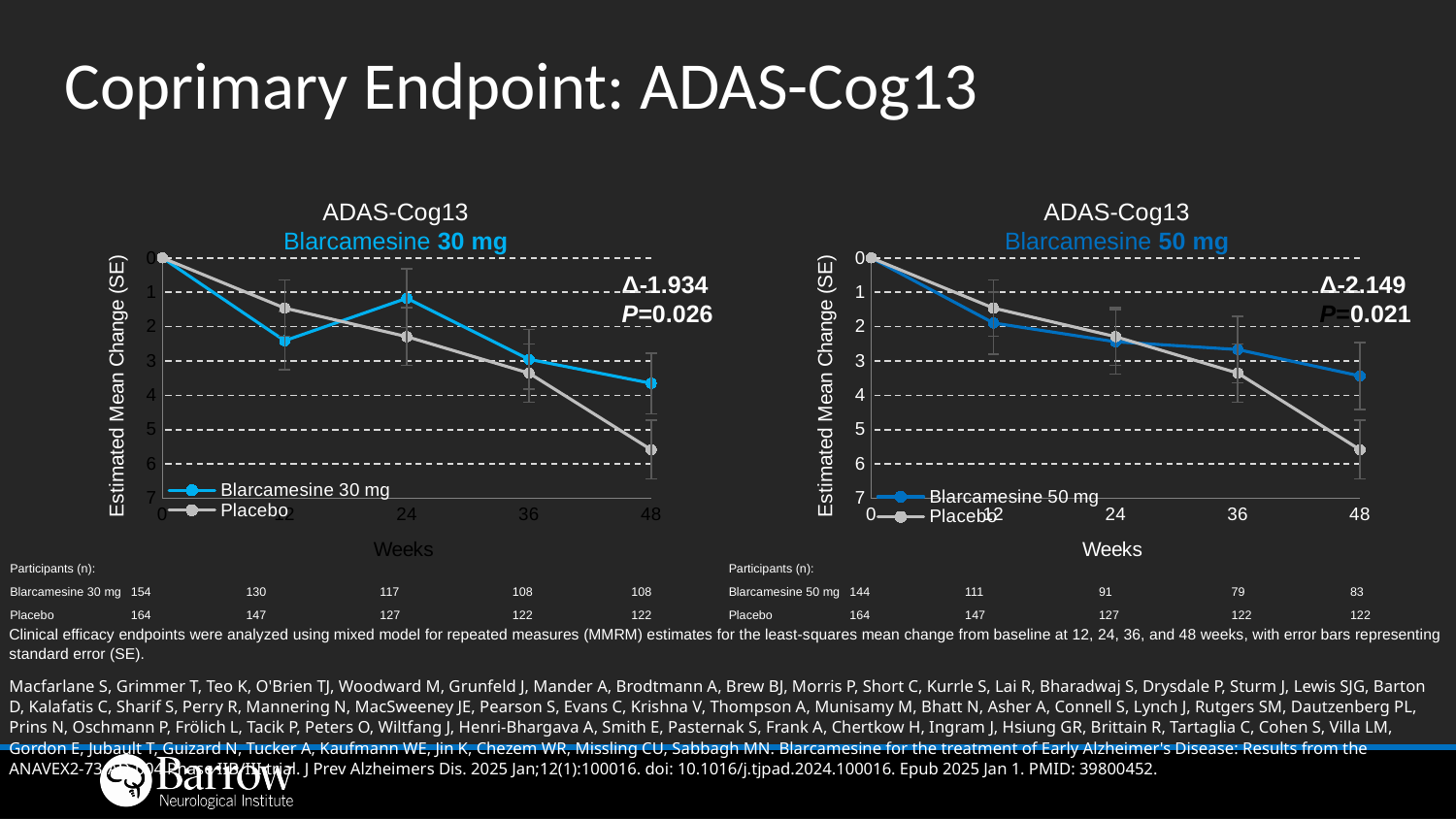
In the ADAS-Cog13 Blarcamesine 50 mg chart on the right, which series has the larger estimated mean change at week 48, Blarcamesine 50 mg or Placebo? Placebo In the ADAS-Cog13 Blarcamesine 30 mg chart on the left, how many time points (weeks) are plotted along the x axis? 5 In the ADAS-Cog13 Blarcamesine 30 mg chart on the left, which series has the larger estimated mean change at week 48, Blarcamesine 30 mg or Placebo? Placebo In the ADAS-Cog13 Blarcamesine 50 mg chart on the right, what P value is annotated on the chart? P=0.021 In the ADAS-Cog13 Blarcamesine 30 mg chart on the left, what Δ value is annotated on the chart? Δ-1.934 What kind of chart is the ADAS-Cog13 Blarcamesine 30 mg chart on the left? line chart In the ADAS-Cog13 Blarcamesine 30 mg chart on the left, is the Placebo value at week 48 greater or less than 5? greater In the ADAS-Cog13 Blarcamesine 50 mg chart on the right, is the Blarcamesine 50 mg value at week 48 greater or less than 4? less In the ADAS-Cog13 Blarcamesine 30 mg chart on the left, is the Blarcamesine 30 mg value at week 48 greater or less than 3? greater How many series does the legend of the ADAS-Cog13 Blarcamesine 50 mg chart on the right list? 2 In the ADAS-Cog13 Blarcamesine 50 mg chart on the right, does the Placebo estimated mean change increase or decrease from week 0 to week 48? increase